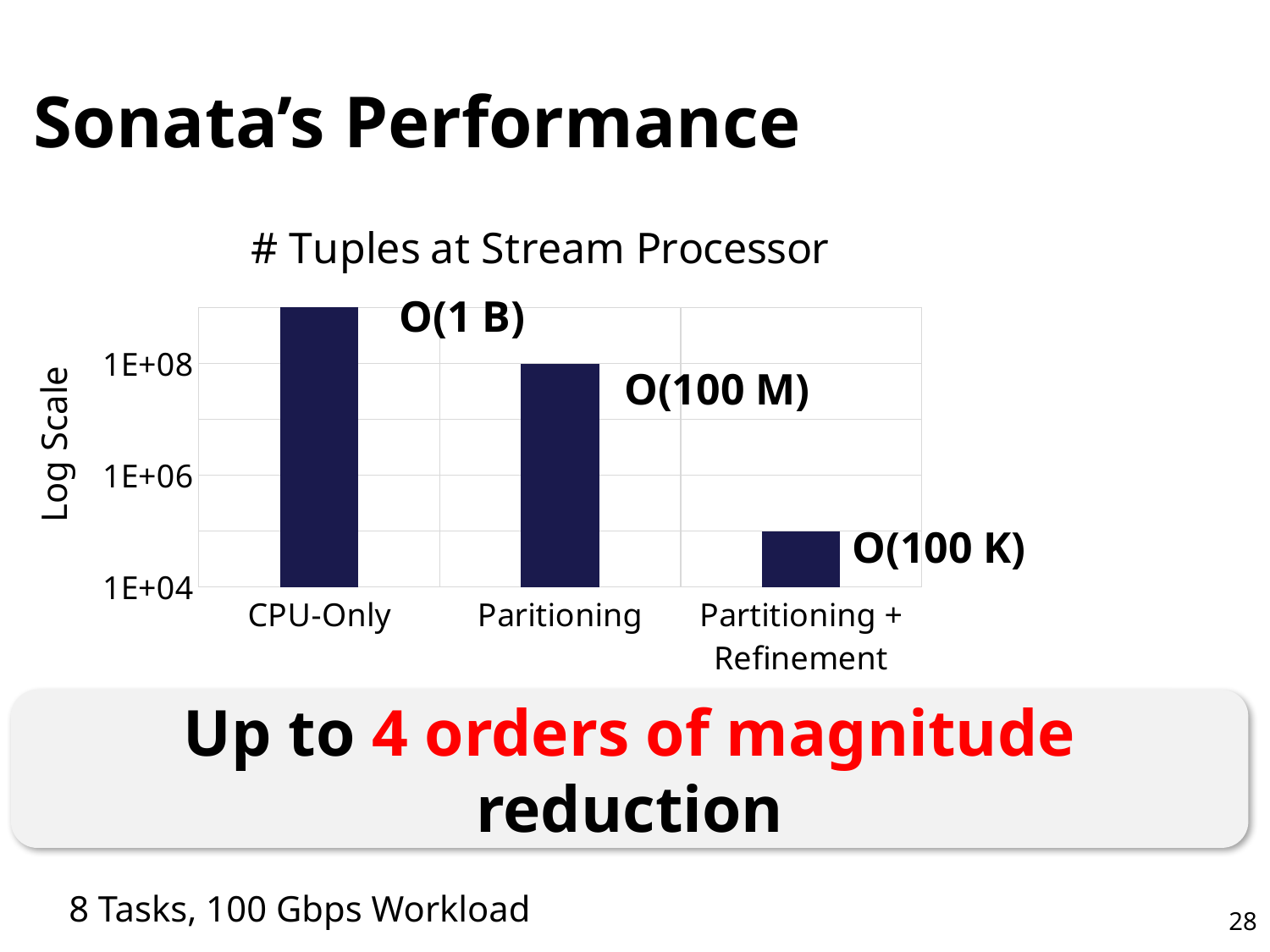
Which category has the highest number of tuples at the stream processor? CPU-Only Is the value for Paritioning + Refinement greater or less than 1E+06? less What kind of chart is shown on the slide? bar chart How many categories are shown on the x axis of the chart? 3 Which has more tuples at the stream processor, CPU-Only or Paritioning? CPU-Only What is the title of the chart? # Tuples at Stream Processor Which has fewer tuples at the stream processor, Paritioning or Paritioning + Refinement? Partitioning + Refinement What order-of-magnitude label is printed next to the CPU-Only bar? O(1 B) Which category has the lowest number of tuples at the stream processor? Partitioning + Refinement What is the label on the vertical axis of the chart? Log Scale Do the values rise or fall moving from left to right across the categories? fall Is the value for CPU-Only greater or less than 1E+08? greater